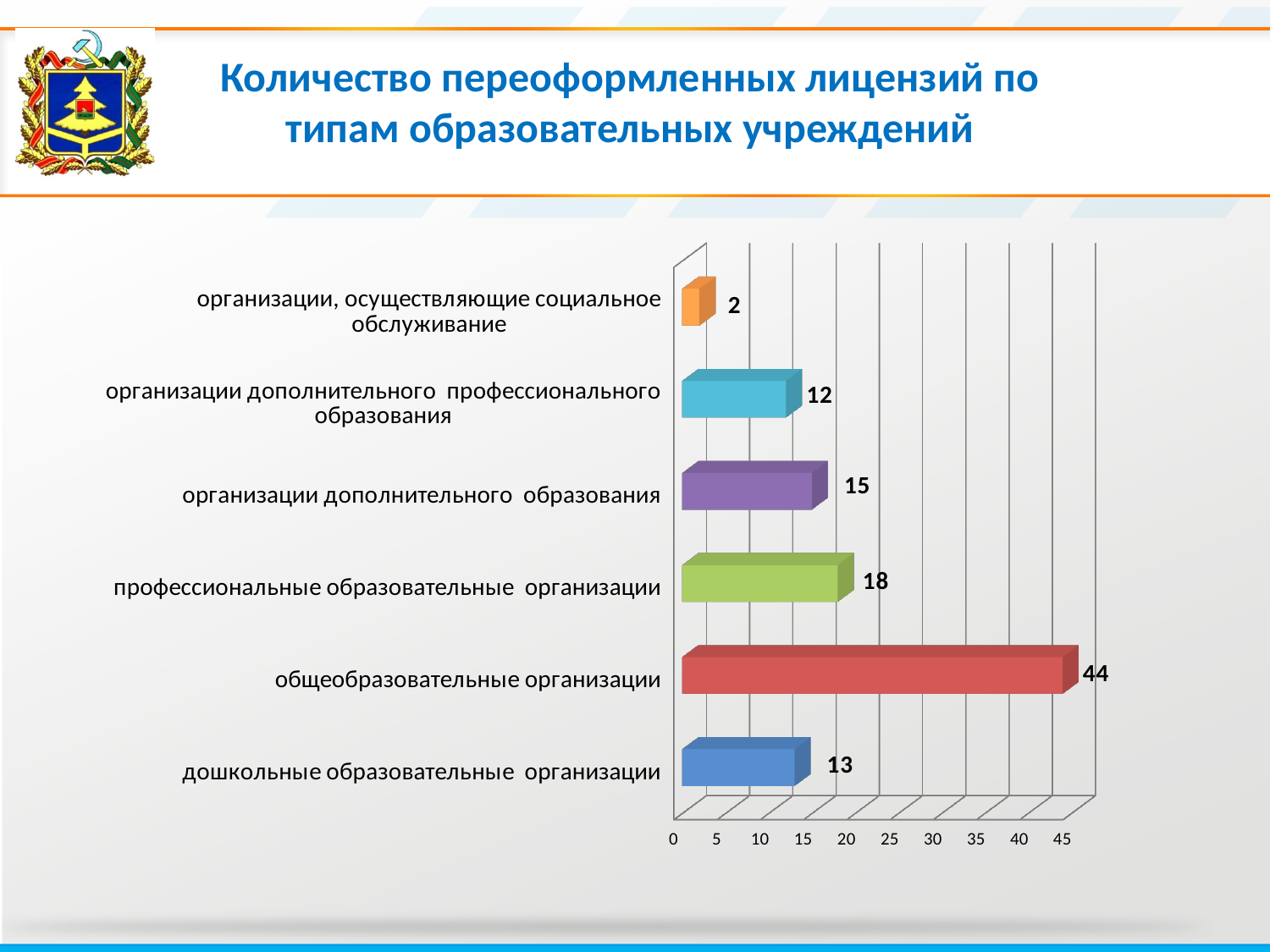
What colour is the bar for общеобразовательные организации? red Which category has the lowest value? организации, осуществляющие социальное обслуживание How many categories are shown in the chart? 6 What is the value for организации дополнительного профессионального образования? 12 Which category has the highest value? общеобразовательные организации What is the value for дошкольные образовательные организации? 13 What kind of chart is shown on the slide? bar chart Is the value for профессиональные образовательные организации greater or less than 20? less What is the value for общеобразовательные организации? 44 What is the title of the slide? Количество переоформленных лицензий по типам образовательных учреждений What is the difference between the values for общеобразовательные организации and профессиональные образовательные организации? 26 Which is larger: the value for организации дополнительного образования or the value for дошкольные образовательные организации? организации дополнительного образования